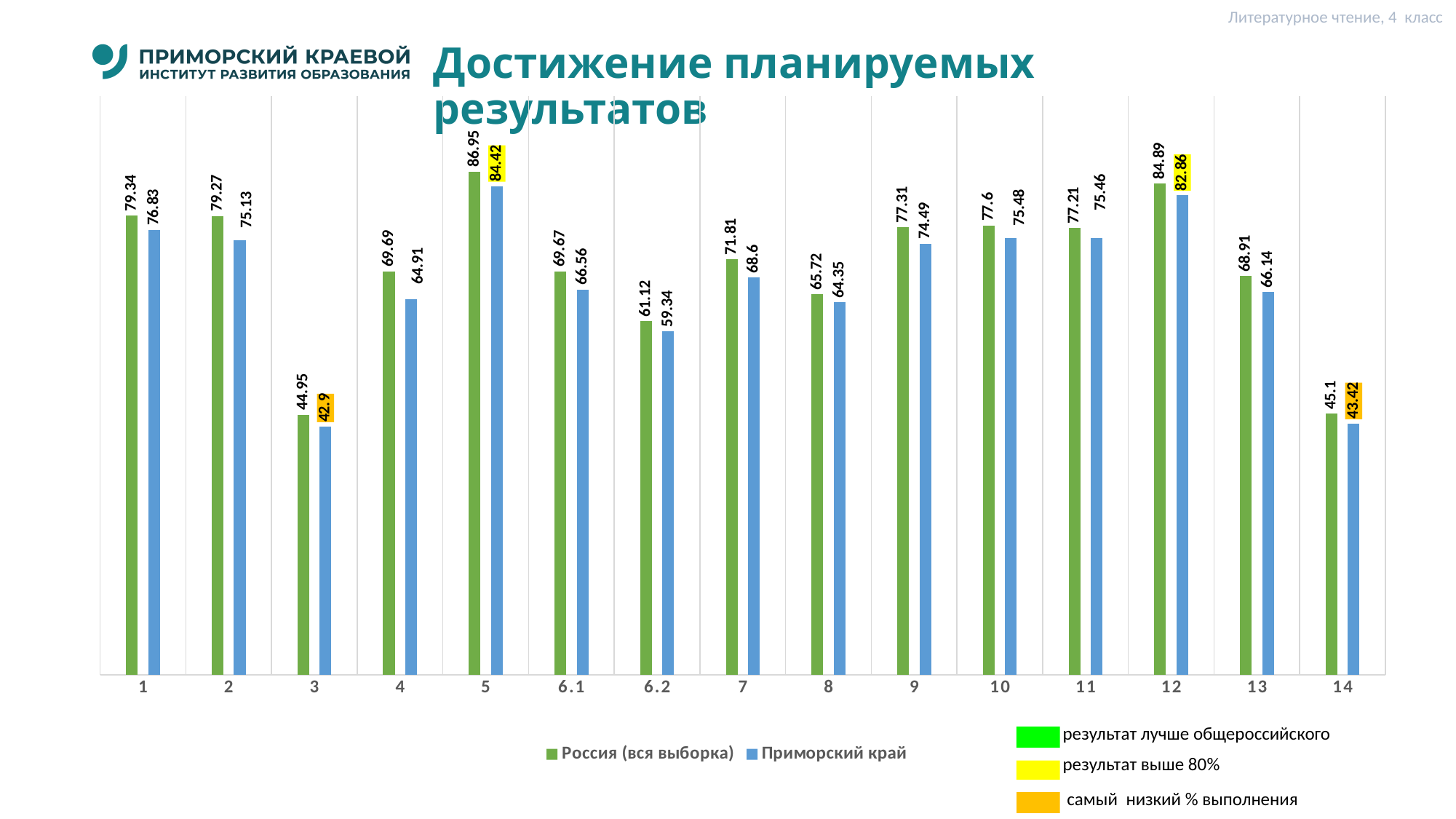
Which task has the lowest value for Приморский край? 3 What is the value for Приморский край for task 5? 84.42 What is the value for Приморский край for task 14? 43.42 How many task categories are shown on the x axis? 15 How many series does the chart legend list? 2 What is the value for Россия (вся выборка) for task 12? 84.89 According to the colour key, what does a yellow highlight on a value label mean? результат выше 80% What type of chart is shown on the slide? Bar chart What is the difference between Россия (вся выборка) and Приморский край for task 4? 4.78 Which is larger for task 9: Россия (вся выборка) or Приморский край? Россия (вся выборка) What is the value for Приморский край for task 6.2? 59.34 Which task has the highest value for Россия (вся выборка)? 5